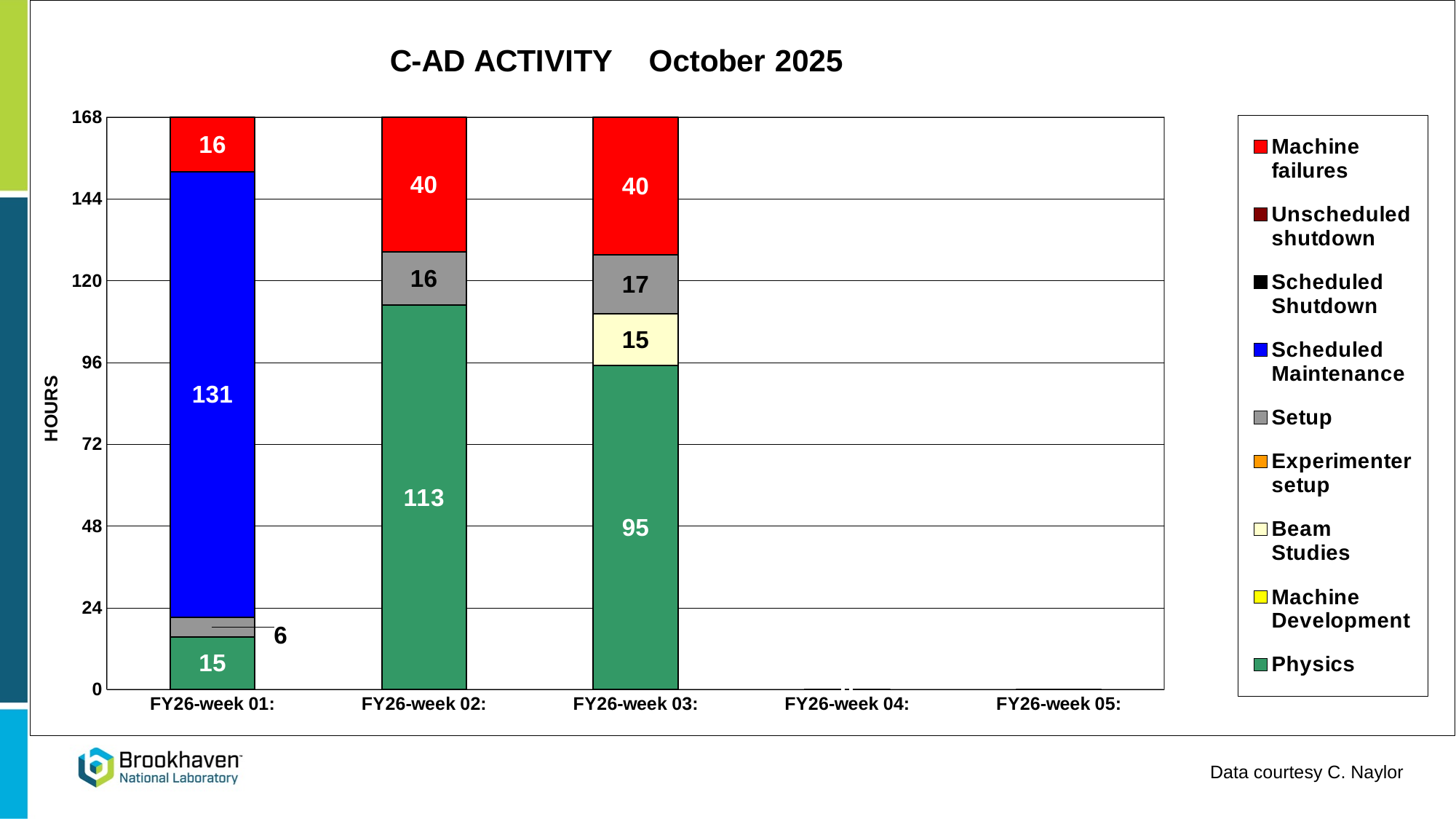
How many hours of Scheduled Maintenance are shown for FY26-week 01? 131 What kind of chart is shown on the slide? stacked bar chart How many series does the legend list? 9 What is the difference in Physics hours between FY26-week 02 and FY26-week 03? 18 What is the total height of the stacked bar for FY26-week 01, summing its labelled segments? 168 How many hours of Setup are shown for FY26-week 01? 6 How many hours of Physics are shown for FY26-week 02? 113 How many week categories are shown on the x axis? 5 Which week has the highest Physics hours? FY26-week 02 How many hours of Beam Studies are shown for FY26-week 03? 15 Which is larger, the Machine failures hours in FY26-week 01 or in FY26-week 02? FY26-week 02 How many hours of Machine failures are shown for FY26-week 03? 40